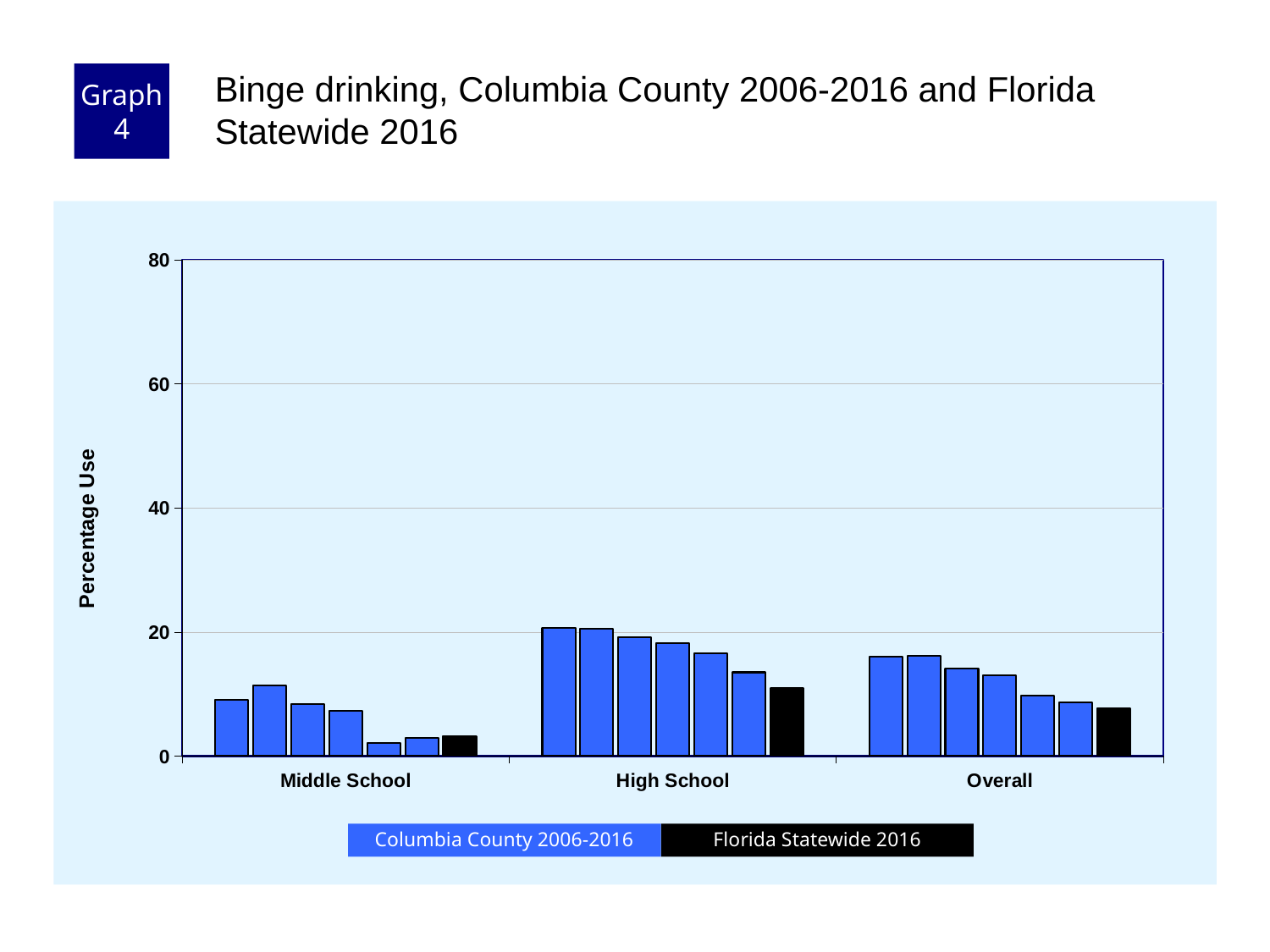
Is the Florida Statewide 2016 value for High School greater or less than 20? less What colour represents Florida Statewide 2016 in the chart's legend? black Which is larger, the Florida Statewide 2016 value for High School or for Middle School? High School Is the Florida Statewide 2016 value for Overall greater or less than 20? less Do the Columbia County 2006-2016 bars for High School rise or fall from left to right? fall Which category has the highest bars in the chart? High School What is the title of the y axis of the chart? Percentage Use Which category has the lowest bars in the chart? Middle School How many categories are shown on the x axis of the chart? 3 How many series does the chart's legend list? 2 Is the Florida Statewide 2016 value for Middle School greater or less than 20? less What kind of chart is shown on the slide? bar chart